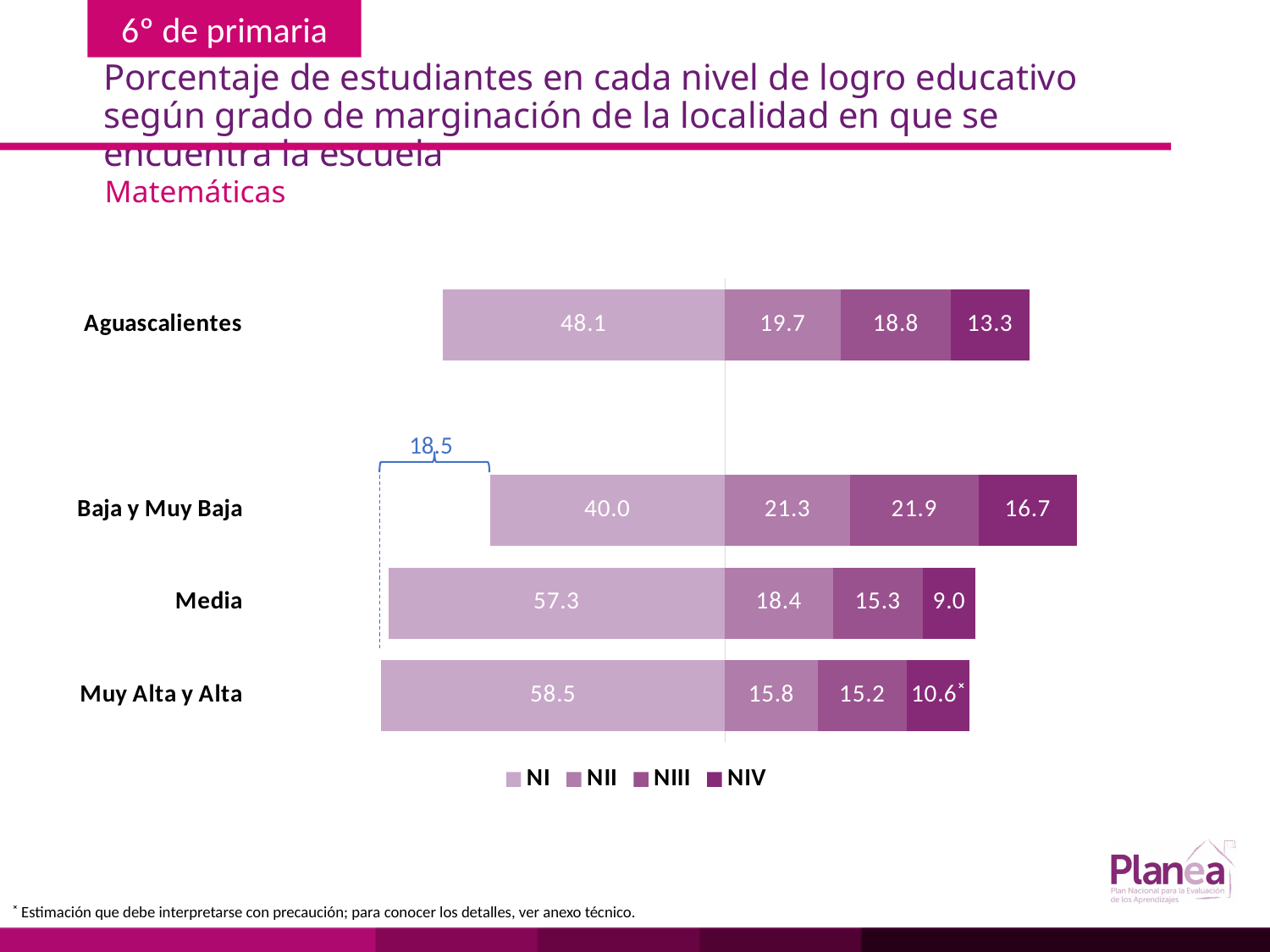
Which has a larger NIII value, Baja y Muy Baja or Aguascalientes? Baja y Muy Baja What is the NII value for Media? 18.4 What value is shown by the bracket annotation above the Baja y Muy Baja bar? 18.5 How many categories are shown on the chart? 4 How many series does the legend list? 4 What is the difference between the NI value for Media and the NI value for Baja y Muy Baja? 17.3 Which category has the lowest NIV value? Media What is the NI value for Aguascalientes? 48.1 What is the NIII value for Muy Alta y Alta? 15.2 Which category has the highest NI value? Muy Alta y Alta What is the NIV value for Baja y Muy Baja? 16.7 What kind of chart is shown on the slide? Stacked bar chart